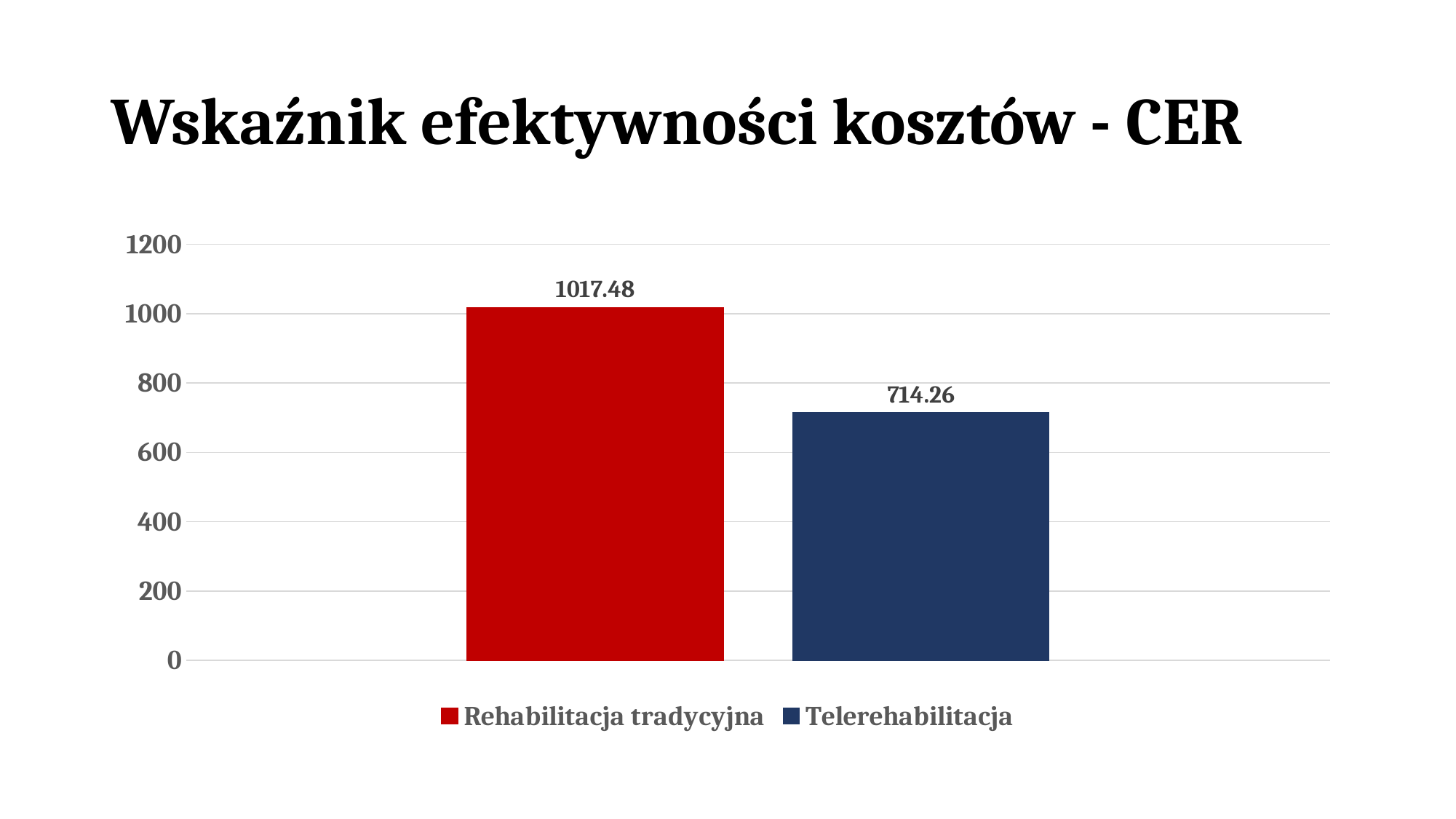
How many bars are plotted on the chart? 2 What is the title of the slide? Wskaźnik efektywności kosztów - CER Is the value for Rehabilitacja tradycyjna greater or less than 1000? greater Which series has the highest value? Rehabilitacja tradycyjna Which series has the lowest value? Telerehabilitacja Is the value for Telerehabilitacja greater or less than 800? less What is the value for Rehabilitacja tradycyjna? 1017.48 What kind of chart is shown on the slide? bar chart What is the value for Telerehabilitacja? 714.26 What is the difference between the values for Rehabilitacja tradycyjna and Telerehabilitacja? 303.22 How many series does the legend list? 2 Which is larger, the value for Rehabilitacja tradycyjna or the value for Telerehabilitacja? Rehabilitacja tradycyjna